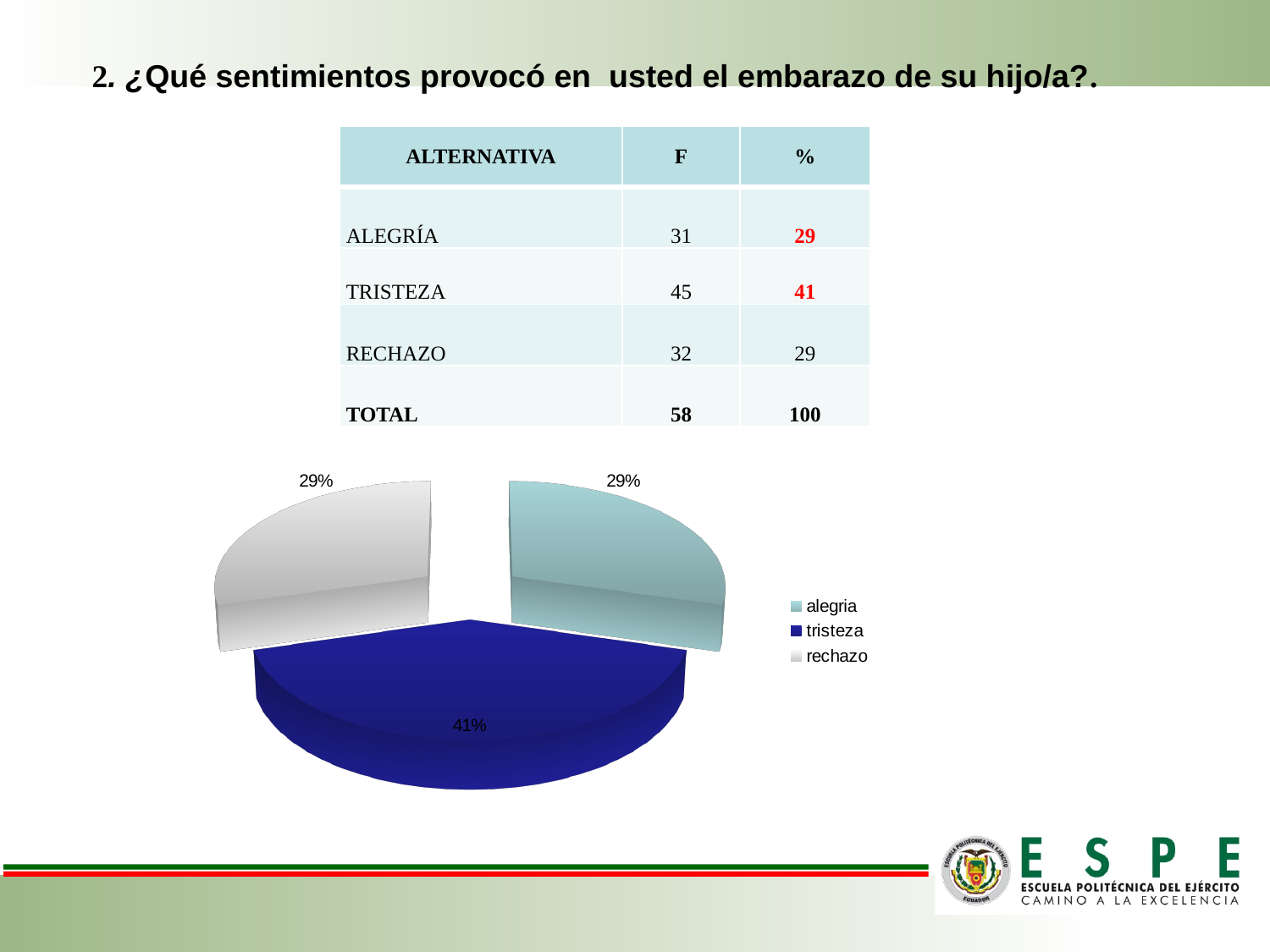
What share of the pie does the tristeza slice take? 41% Which legend entry is listed first in the pie chart's legend? alegria How many slices does the pie chart have? 3 Which slice is larger in the pie chart, tristeza or rechazo? tristeza What percentage of the pie chart does the alegria slice represent? 29% What percentage of the pie chart does the tristeza slice represent? 41% Which category has the largest slice in the pie chart? tristeza What kind of chart is shown on the slide? pie chart How many entries does the legend of the pie chart list? 3 What percentage of the pie chart does the rechazo slice represent? 29% What is the difference in percentage points between the tristeza slice and the alegria slice? 12 What colour is the tristeza slice in the pie chart? blue